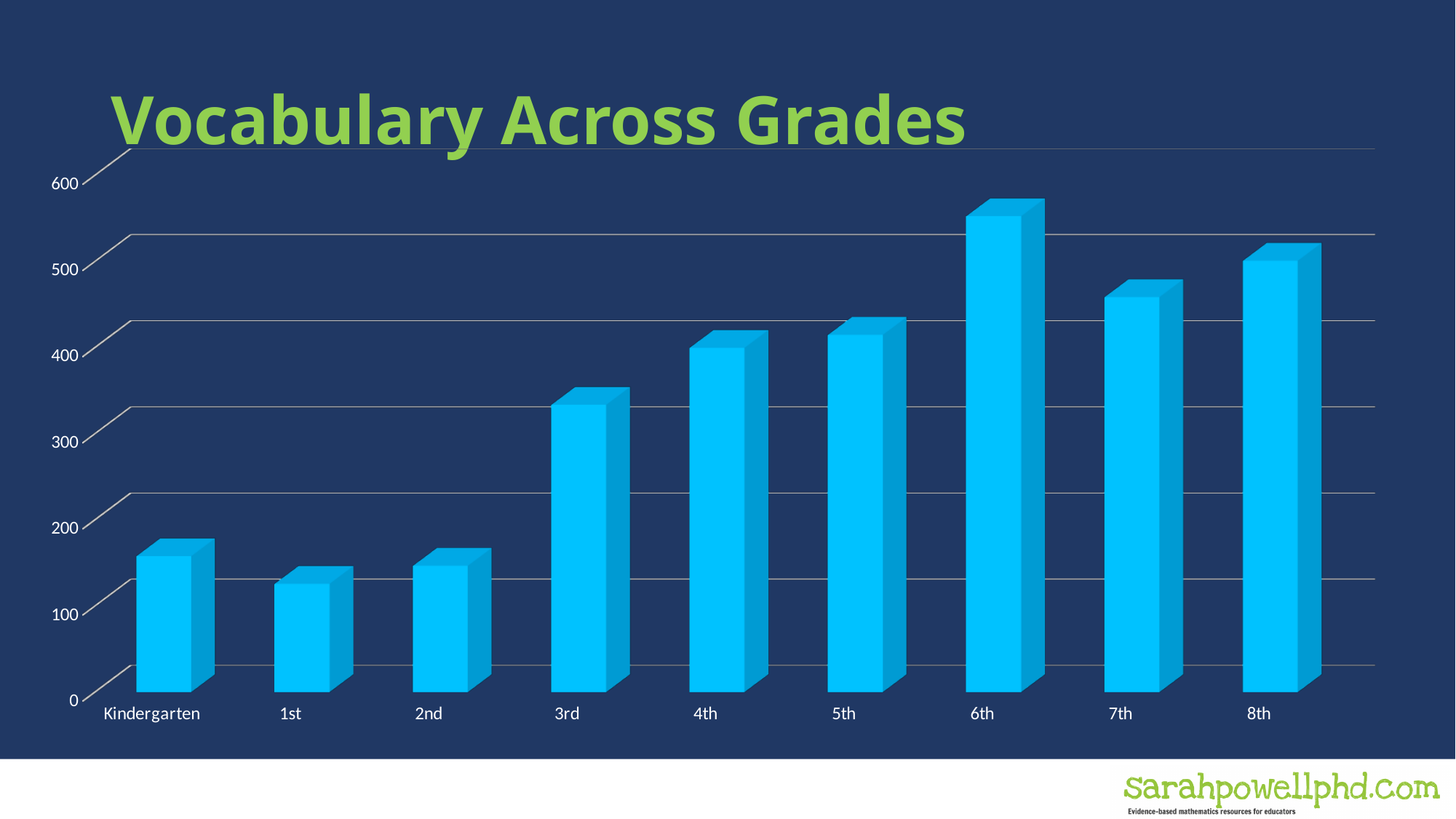
Is the value for 3rd grade greater or less than 300? greater What is the title of the chart? Vocabulary Across Grades Is the value for 7th grade greater or less than 500? less Which grade has the lowest bar? 1st Is the value for 1st grade greater or less than 200? less Which is larger, the value for 6th grade or the value for 7th grade? 6th Which is larger, the value for Kindergarten or the value for 1st grade? Kindergarten How many grade categories are plotted on the x axis? 9 Do the values generally rise or fall from Kindergarten to 8th grade? rise Which grade has the highest bar? 6th What kind of chart is shown on the slide? bar chart